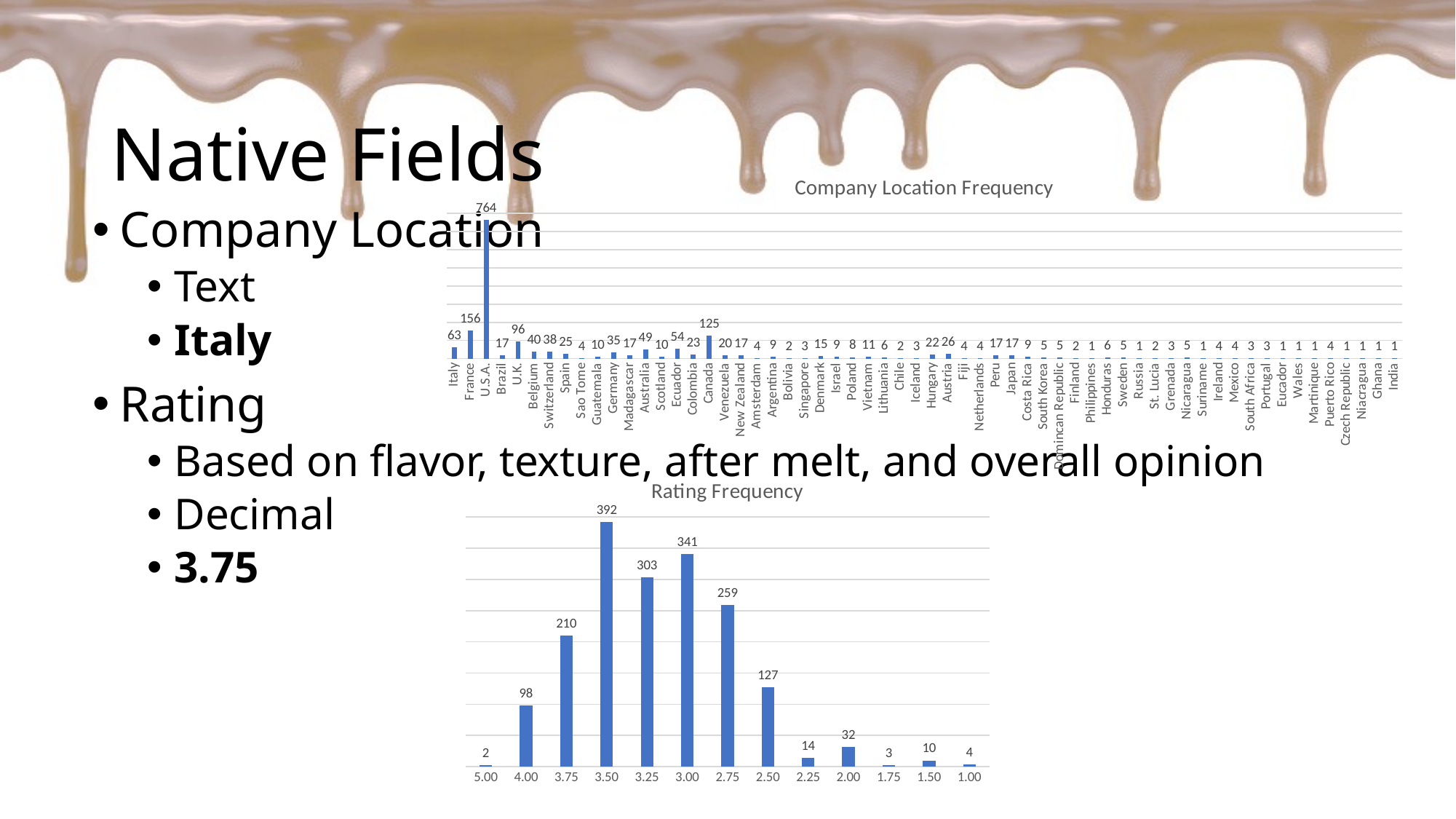
In the Rating Frequency chart, what is the value for the 3.50 rating? 392 What kind of chart is the Rating Frequency chart? bar chart In the Company Location Frequency chart, what is the difference between the values for France and Italy? 93 In the Company Location Frequency chart, what is the value for U.S.A.? 764 In the Rating Frequency chart, what is the difference between the values for 3.00 and 3.25? 38 In the Rating Frequency chart, which rating has the highest frequency? 3.50 How many rating categories are shown in the Rating Frequency chart? 13 In the Rating Frequency chart, which is larger, the value for 2.75 or the value for 2.50? 2.75 In the Company Location Frequency chart, which is larger, the value for U.K. or the value for Belgium? U.K. In the Company Location Frequency chart, which location has the highest frequency? U.S.A. In the Company Location Frequency chart, what is the value for Canada? 125 In the Rating Frequency chart, which rating has the lowest frequency? 5.00